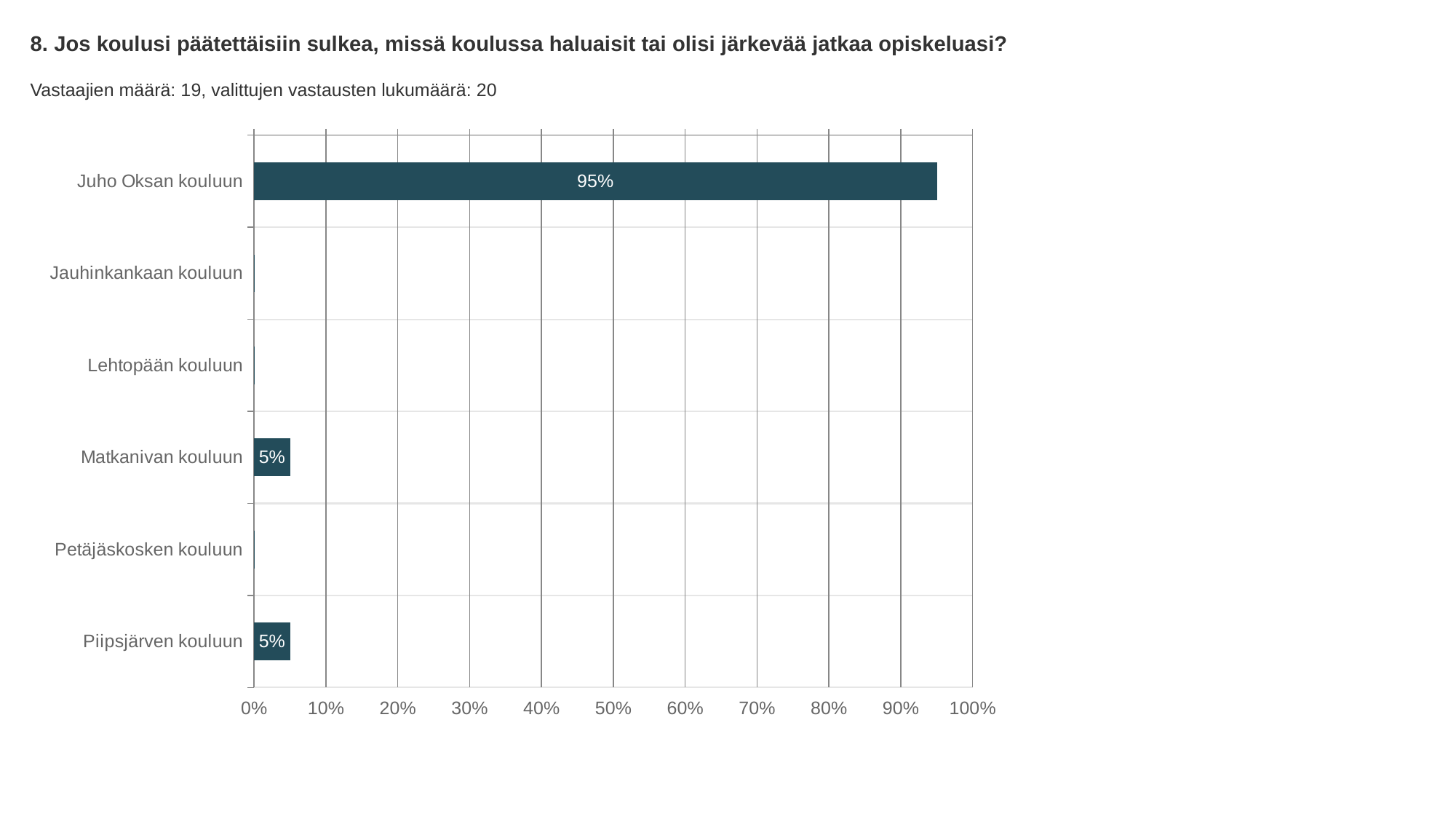
What kind of chart is shown on the slide? bar chart What is the highest tick value shown on the x axis? 100% Is the value for Juho Oksan kouluun greater or less than 90%? greater How many categories are shown on the chart? 6 What is the value for Juho Oksan kouluun? 95% What is the difference between the values for Juho Oksan kouluun and Matkanivan kouluun? 90% What is the value for Matkanivan kouluun? 5% How many categories have a visible bar with a data label? 3 Is the value for Matkanivan kouluun greater or less than 10%? less Which category has the highest value? Juho Oksan kouluun What is the value for Piipsjärven kouluun? 5% Which is larger, the value for Juho Oksan kouluun or the value for Piipsjärven kouluun? Juho Oksan kouluun